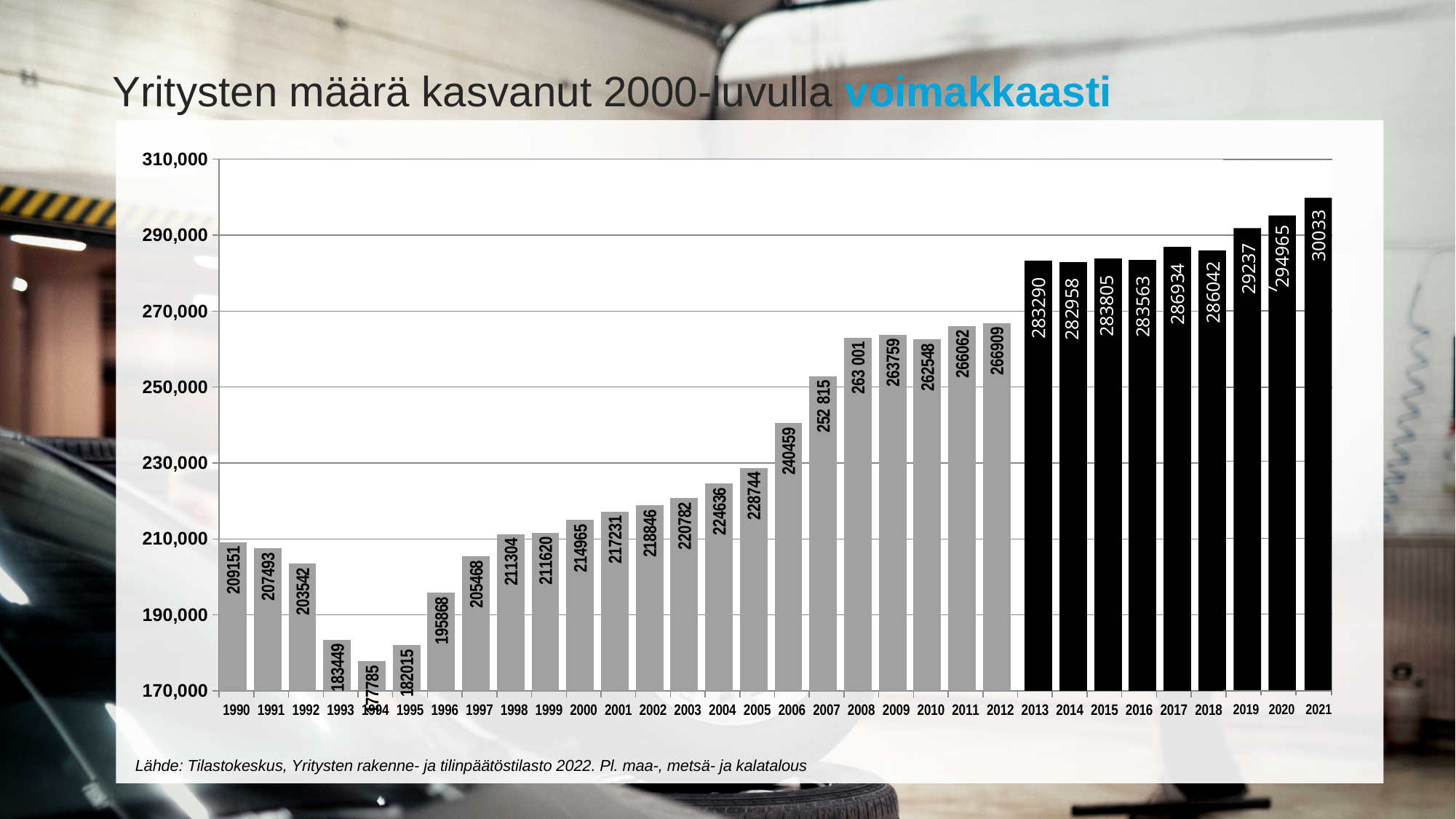
What is the difference between the values for 2012 and 2011? 847 Is the value for 2021 greater or less than 290,000? greater Do the values rise or fall from 2013 to 2021? rise Which year has the lowest value? 1994 How many years are shown on the x axis? 32 What is the value for 2020? 294965 Which year has the highest value? 2021 What kind of chart is shown on the slide? bar chart What is the value for 2007? 252 815 Which is larger, the value for 2017 or the value for 2018? 2017 What is the value for 2013? 283290 What is the value for 1990? 209151